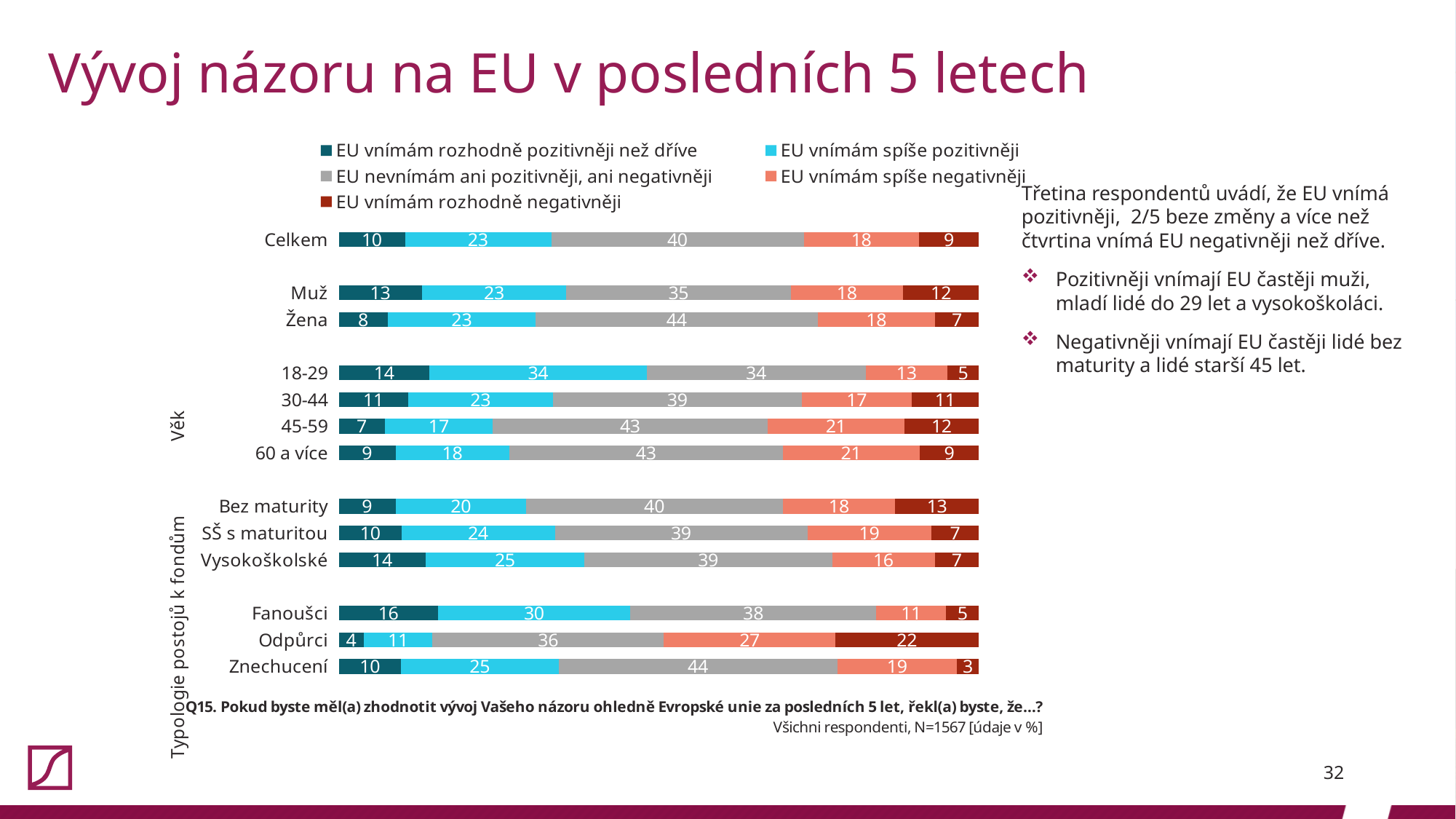
Which category has the highest value for "EU vnímám rozhodně pozitivněji než dříve"? Fanoušci What is the total of the stacked bar for Znechucení? 101 What type of chart is shown on the slide? stacked bar chart What is the value of "EU vnímám rozhodně pozitivněji než dříve" for Vysokoškolské? 14 What is the value of "EU nevnímám ani pozitivněji, ani negativněji" for Celkem? 40 Which has a larger value for "EU vnímám rozhodně negativněji": Muž or Žena? Muž What is the value of "EU vnímám spíše pozitivněji" for 18-29? 34 Which category has the lowest value for "EU vnímám spíše pozitivněji"? Odpůrci What is the difference between the "EU vnímám spíše negativněji" values for Odpůrci and Fanoušci? 16 What is the value of "EU vnímám rozhodně negativněji" for Odpůrci? 22 How many categories (bars) are plotted in the chart? 13 How many series does the legend list? 5